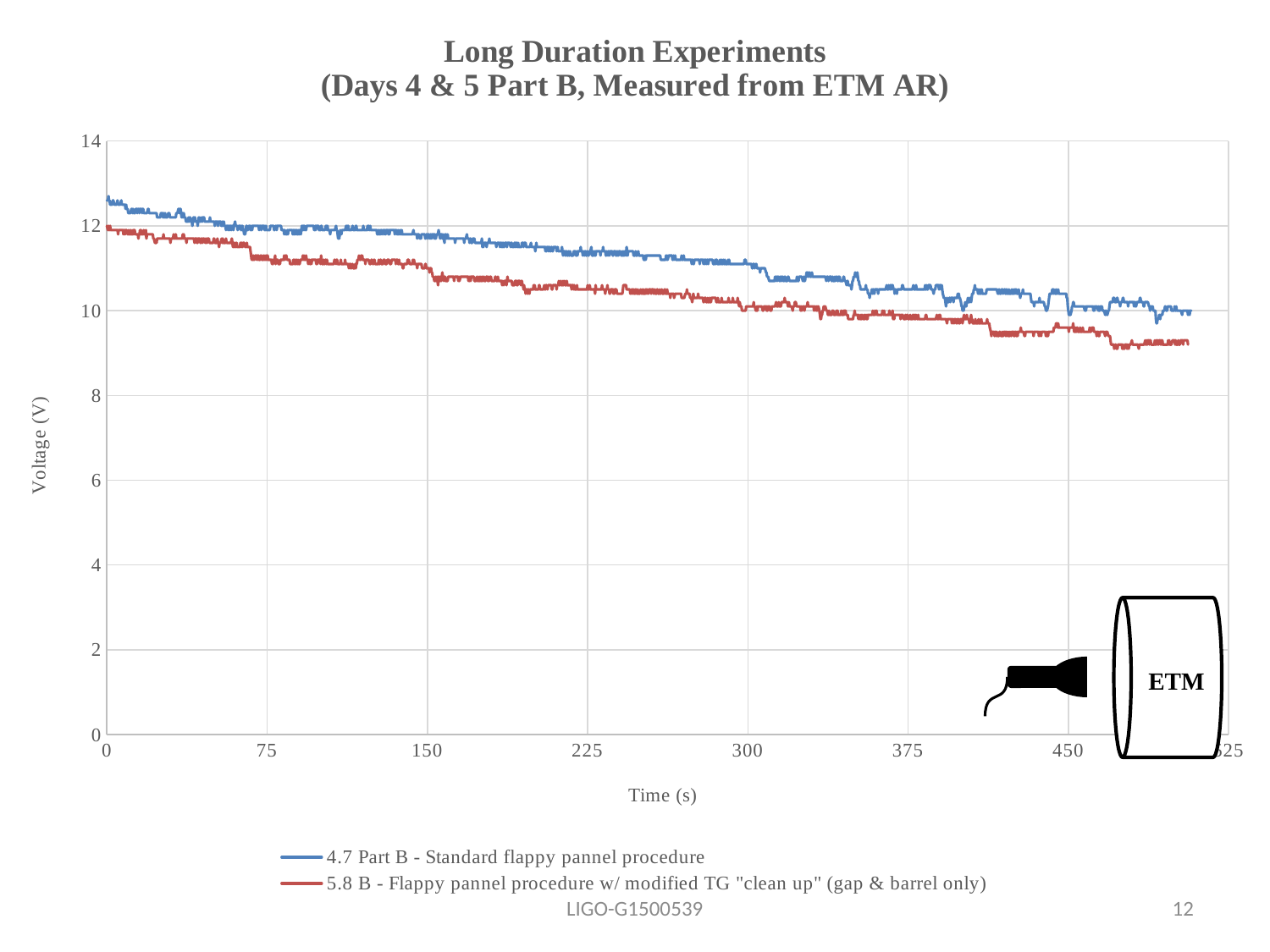
Is the voltage for the '4.7 Part B' series at time 0 greater or less than 12? greater Does the voltage for the '4.7 Part B - Standard flappy pannel procedure' series rise or fall as time increases? fall Does the voltage for the '5.8 B - Flappy pannel procedure w/ modified TG "clean up" (gap & barrel only)' series rise or fall over time? fall Which series has the higher voltage at 300 s? 4.7 Part B - Standard flappy pannel procedure Which series stays lower in voltage across the whole time range? 5.8 B - Flappy pannel procedure w/ modified TG "clean up" (gap & barrel only) Is the voltage for the '5.8 B' series at 450 s greater or less than 10? less Is the voltage for the '4.7 Part B' series at 450 s greater or less than 10? greater What colour is the line for the '5.8 B - Flappy pannel procedure w/ modified TG "clean up" (gap & barrel only)' series? red What is the label of the y axis? Voltage (V) What kind of chart is shown on the slide? line chart How many series does the legend list? 2